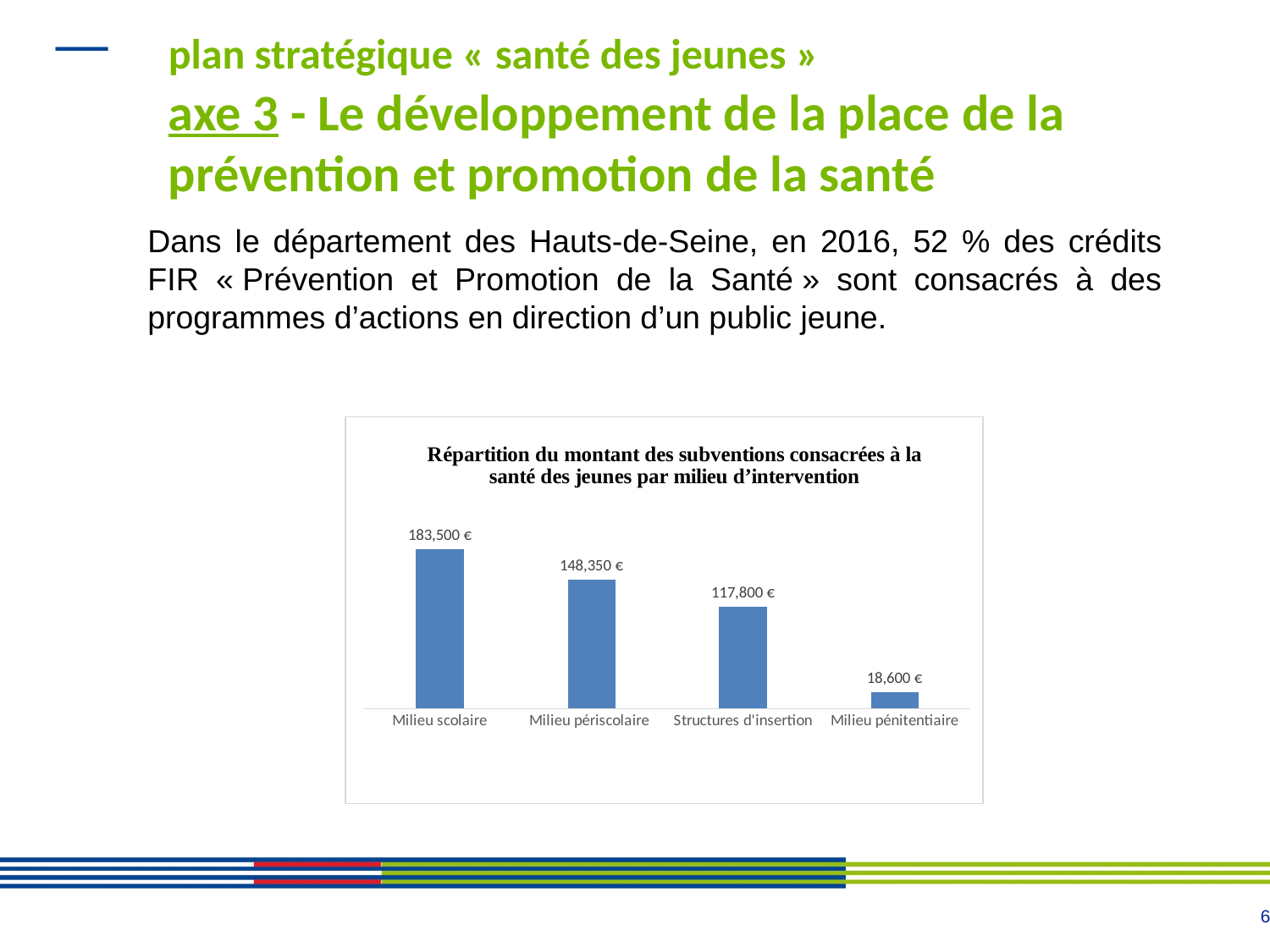
How many categories are shown in the chart? 4 Which category has the highest value? Milieu scolaire Which is larger, the value for Milieu périscolaire or the value for Structures d'insertion? Milieu périscolaire What is the value for Structures d'insertion? 117,800 € Which category has the lowest value? Milieu pénitentiaire What is the difference between the values for Milieu scolaire and Milieu périscolaire? 35,150 € What is the value for Milieu périscolaire? 148,350 € What is the difference between the values for Structures d'insertion and Milieu pénitentiaire? 99,200 € What kind of chart is shown on the slide? Bar chart What is the value for Milieu pénitentiaire? 18,600 € What is the value for Milieu scolaire? 183,500 € Do the values rise or fall from left to right along the x axis? Fall